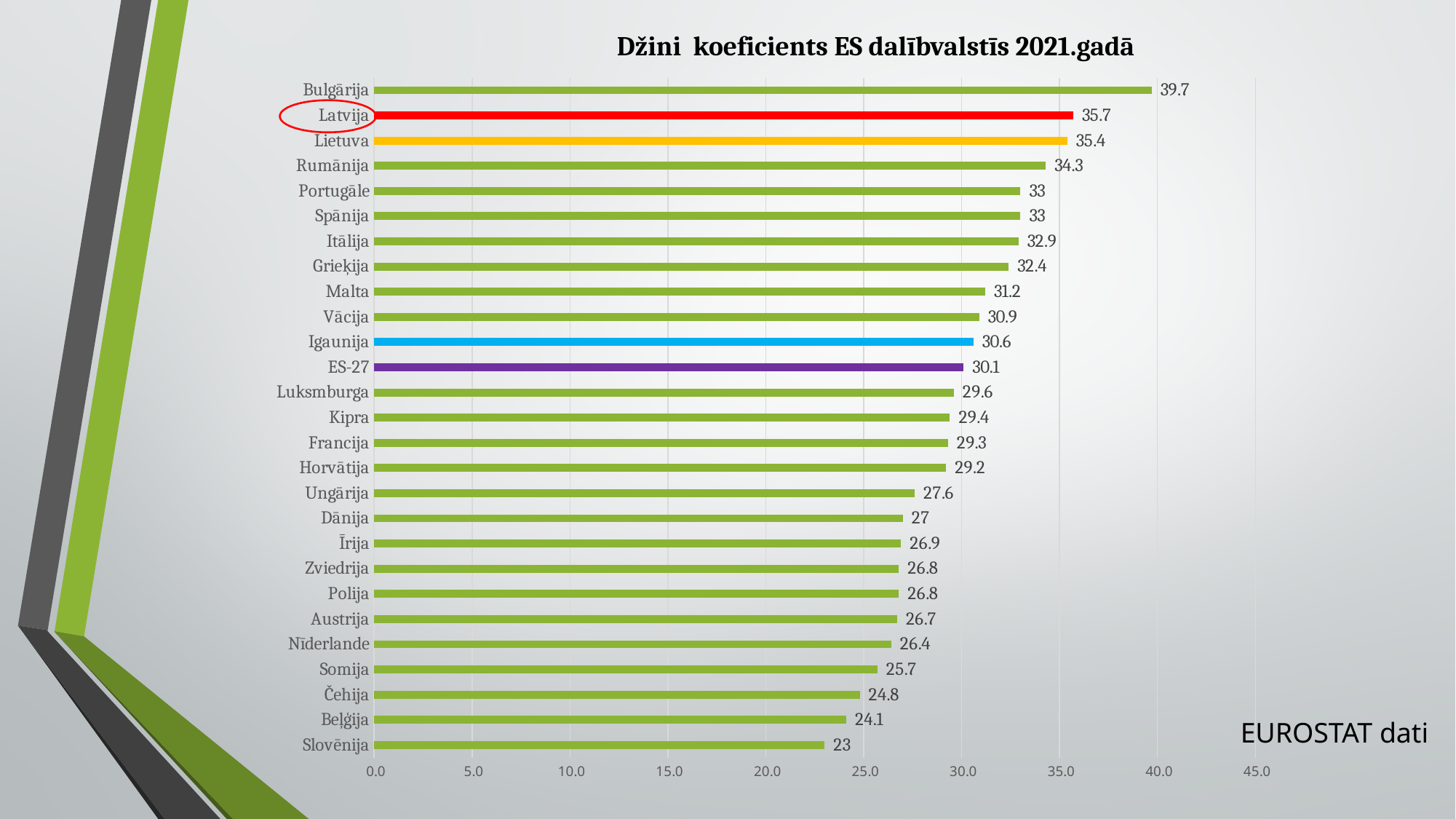
What is the value shown for ES-27? 30.1 What is the difference between the values for Bulgārija and Slovēnija? 16.7 What is the title of the chart? Džini koeficients ES dalībvalstīs 2021.gadā What is the Gini coefficient value shown for Latvija? 35.7 Which country has the lowest Gini coefficient on the chart? Slovēnija How many bars are shown on the chart? 27 What is the value shown for Igaunija? 30.6 Which has a higher value, Rumānija or Portugāle? Rumānija What is the difference between the values for Latvija and Lietuva? 0.3 Which country has the highest Gini coefficient on the chart? Bulgārija Is the value for Somija greater or less than 25.0? greater What type of chart is shown on the slide? Bar chart